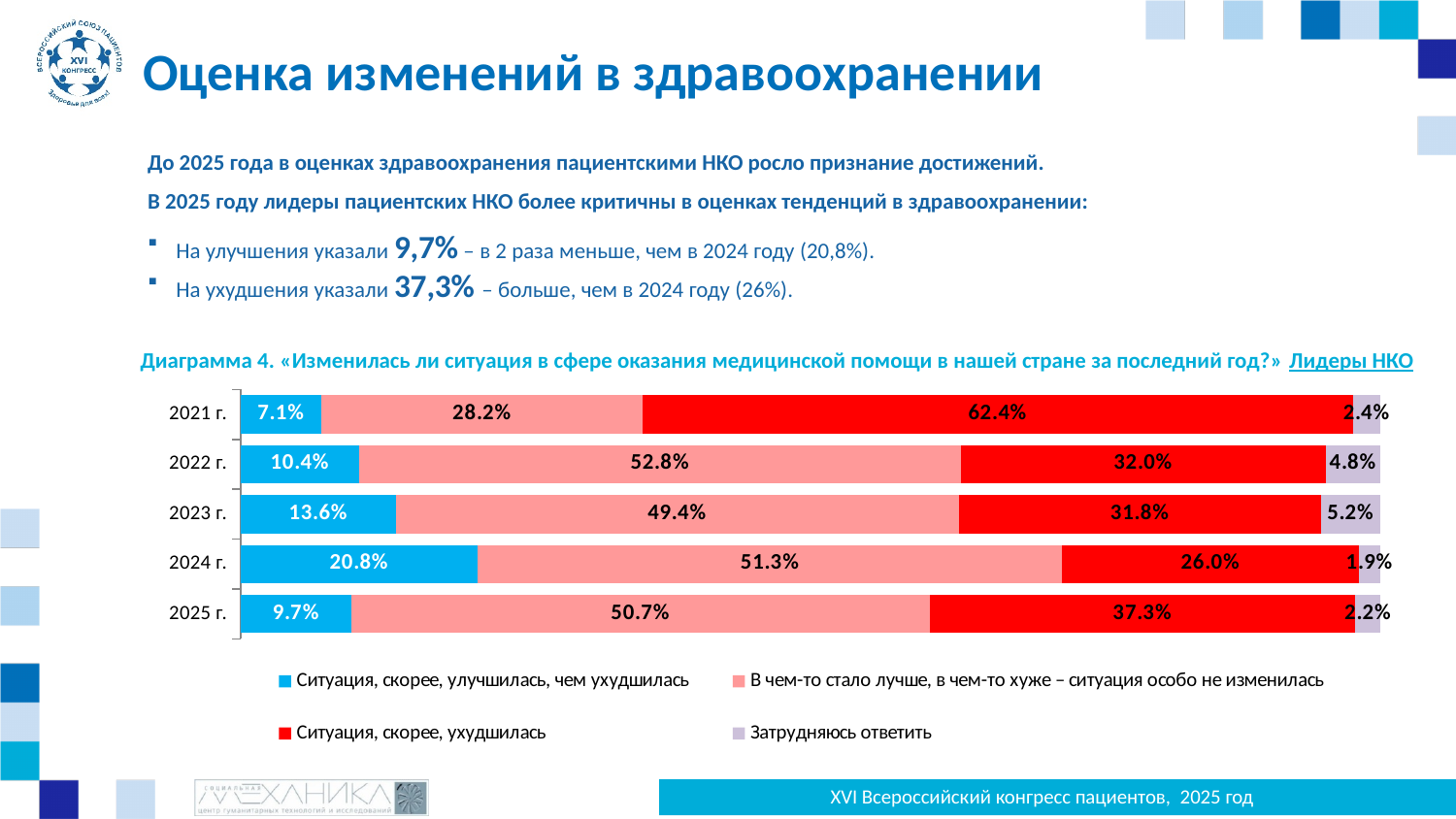
In which year was the share of 'Ситуация, скорее, ухудшилась' the highest? 2021 г. By how many percentage points did the share of 'Ситуация, скорее, ухудшилась' change from 2024 to 2025? 11.3 percentage points What is the value for 'Ситуация, скорее, улучшилась, чем ухудшилась' in 2021? 7.1% What is the value for 'Затрудняюсь ответить' in 2023? 5.2% How many years are shown in the chart? 5 Which year has the larger value for 'В чем-то стало лучше, в чем-то хуже – ситуация особо не изменилась': 2022 or 2023? 2022 г. In which year was the share of 'Затрудняюсь ответить' the lowest? 2024 г. In which year was the share of 'Ситуация, скорее, улучшилась, чем ухудшилась' the highest? 2024 г. Did the share of 'Ситуация, скорее, улучшилась, чем ухудшилась' rise or fall from 2021 to 2024? Rise What kind of chart is shown on the slide? Stacked horizontal bar chart What percentage of NGO leaders in 2025 said the situation had rather worsened (Ситуация, скорее, ухудшилась)? 37.3% How many series does the legend list? 4